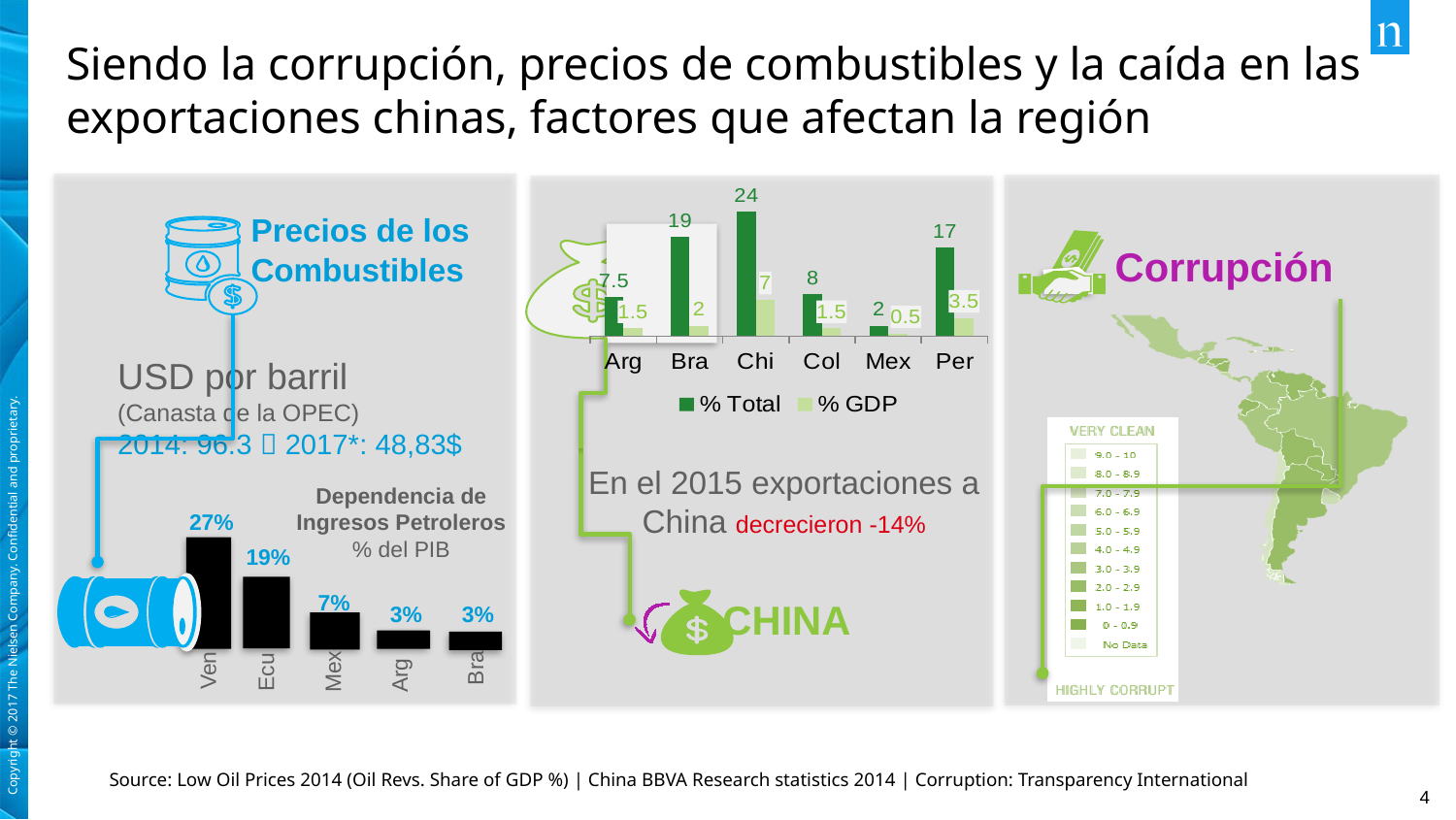
In the China exports chart (middle panel), is the % Total value for Bra larger than that for Per? Yes, Bra (19) is larger than Per (17) In the 'Dependencia de Ingresos Petroleros' chart, what is the difference between Ven and Ecu? 8% In the 'Dependencia de Ingresos Petroleros' chart, what is the value for Ven? 27% In the 'Dependencia de Ingresos Petroleros' chart, what is the value for Mex? 7% In the China exports chart (middle panel), how many series does the legend list? 2 What type of chart is the 'Dependencia de Ingresos Petroleros' chart? Bar chart In the China exports chart (middle panel), what is the % Total value for Chi? 24 In the China exports chart (middle panel), which country has the highest % GDP value? Chi In the China exports chart (middle panel), what is the % GDP value for Per? 3.5 In the 'Dependencia de Ingresos Petroleros' chart, which country has the highest value? Ven In the China exports chart (middle panel), which country has the lowest % Total value? Mex In the 'Dependencia de Ingresos Petroleros' chart, how many countries are shown? 5